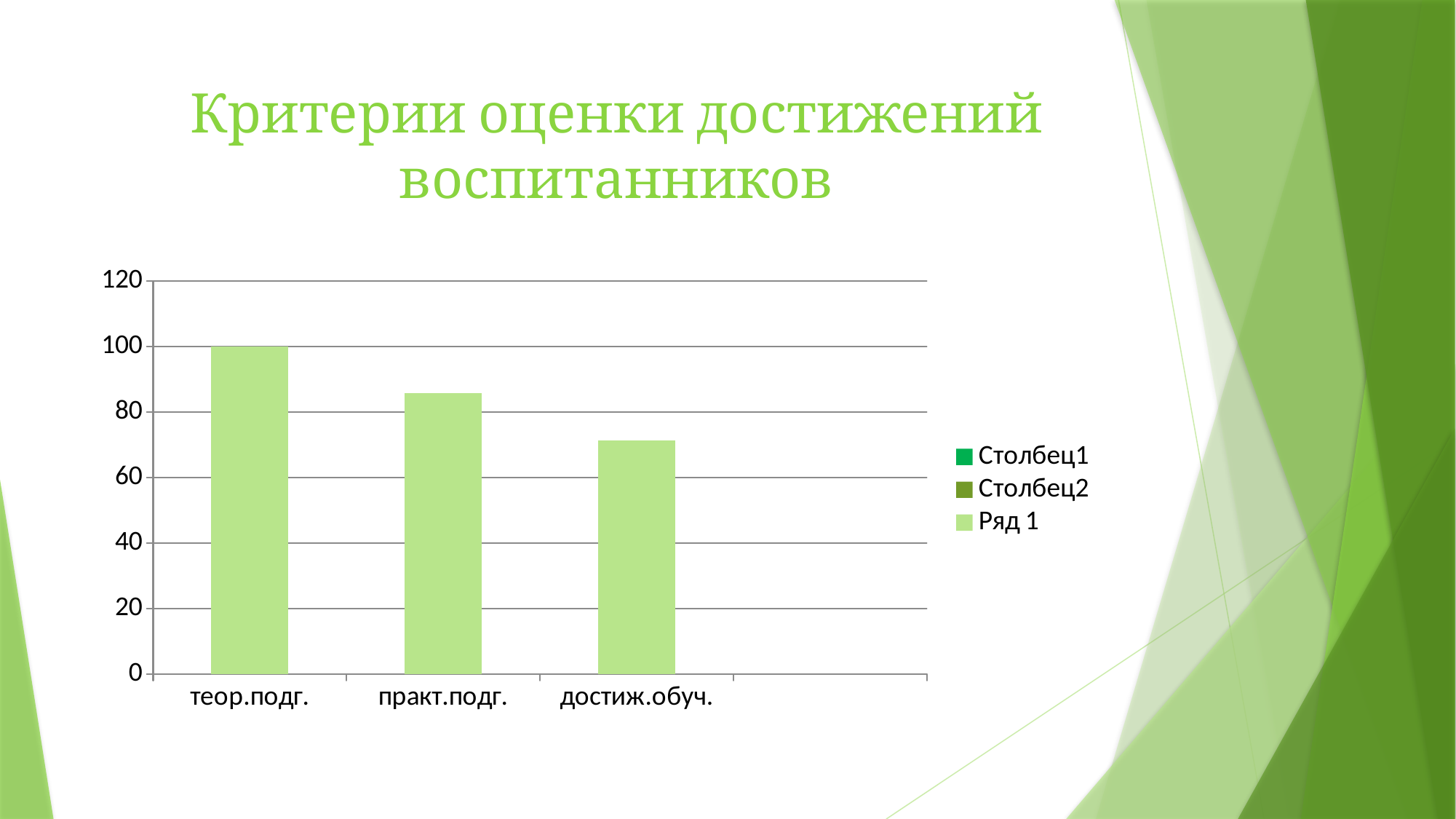
What kind of chart is shown on the slide? bar chart Which category has the highest value? теор.подг. What is the title of the slide containing the chart? Критерии оценки достижений воспитанников Which category has the lowest value? достиж.обуч. Is the value for практ.подг. greater or less than 80? greater Is the value for достиж.обуч. greater or less than 80? less Is the value for достиж.обуч. greater or less than 60? greater How many entries does the chart's legend list? 3 How many categories are shown on the x axis of the chart? 3 Which is larger, the value for практ.подг. or the value for достиж.обуч.? практ.подг. What is the value for теор.подг.? 100 Do the values rise or fall from left to right along the x axis? fall